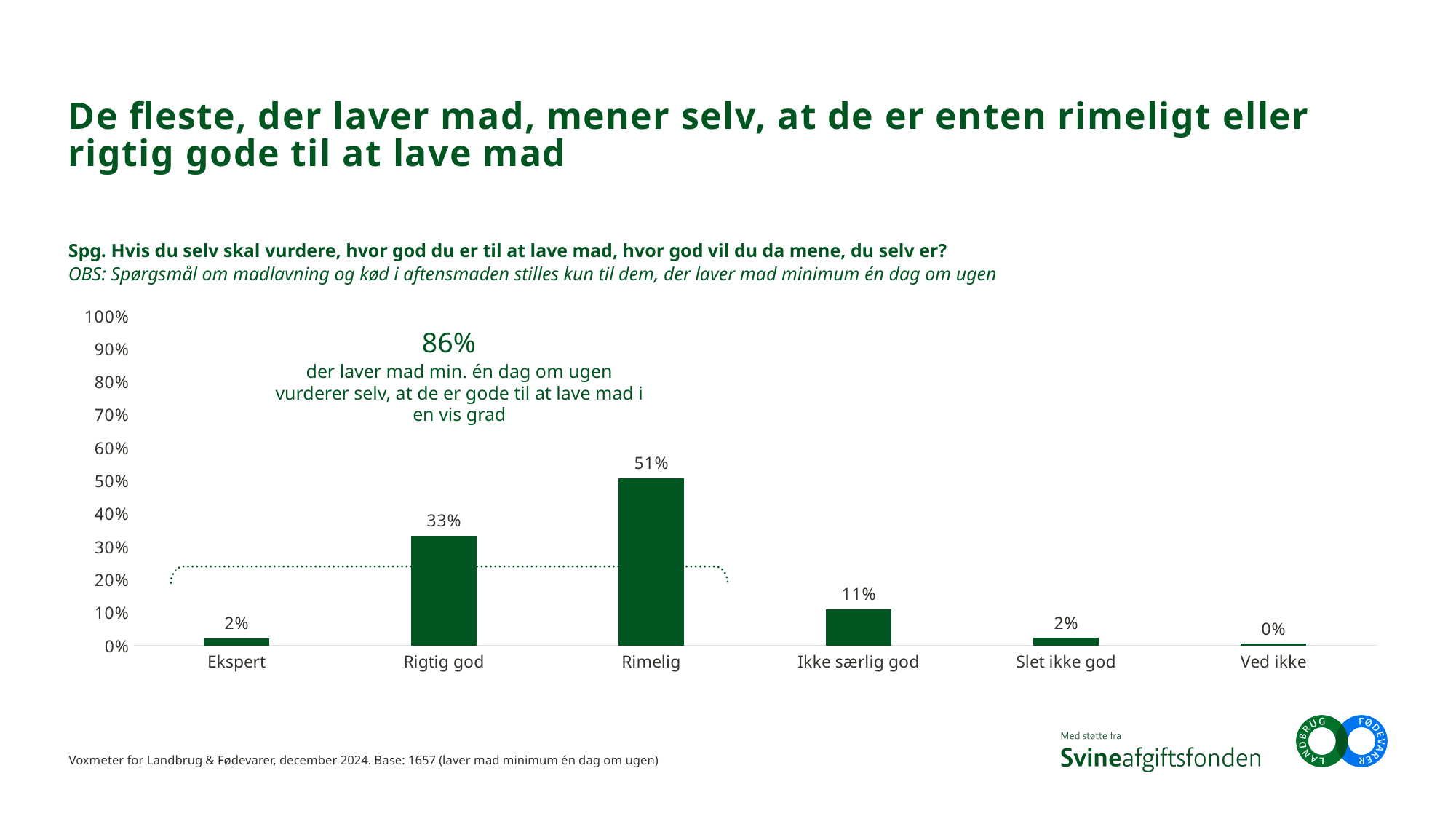
What is the value for Ikke særlig god? 11% Which is larger, the value for Ikke særlig god or the value for Slet ikke god? Ikke særlig god What is the value for Rimelig? 51% What kind of chart is shown on the slide? Bar chart What is the value for Ekspert? 2% Which category has the lowest value? Ved ikke What is the value for Ved ikke? 0% What percentage is highlighted in the annotation above the Rigtig god and Rimelig bars? 86% Which category has the highest value? Rimelig What is the difference between the values for Rimelig and Rigtig god? 18% What is the value for Rigtig god? 33% How many categories are shown on the x axis? 6